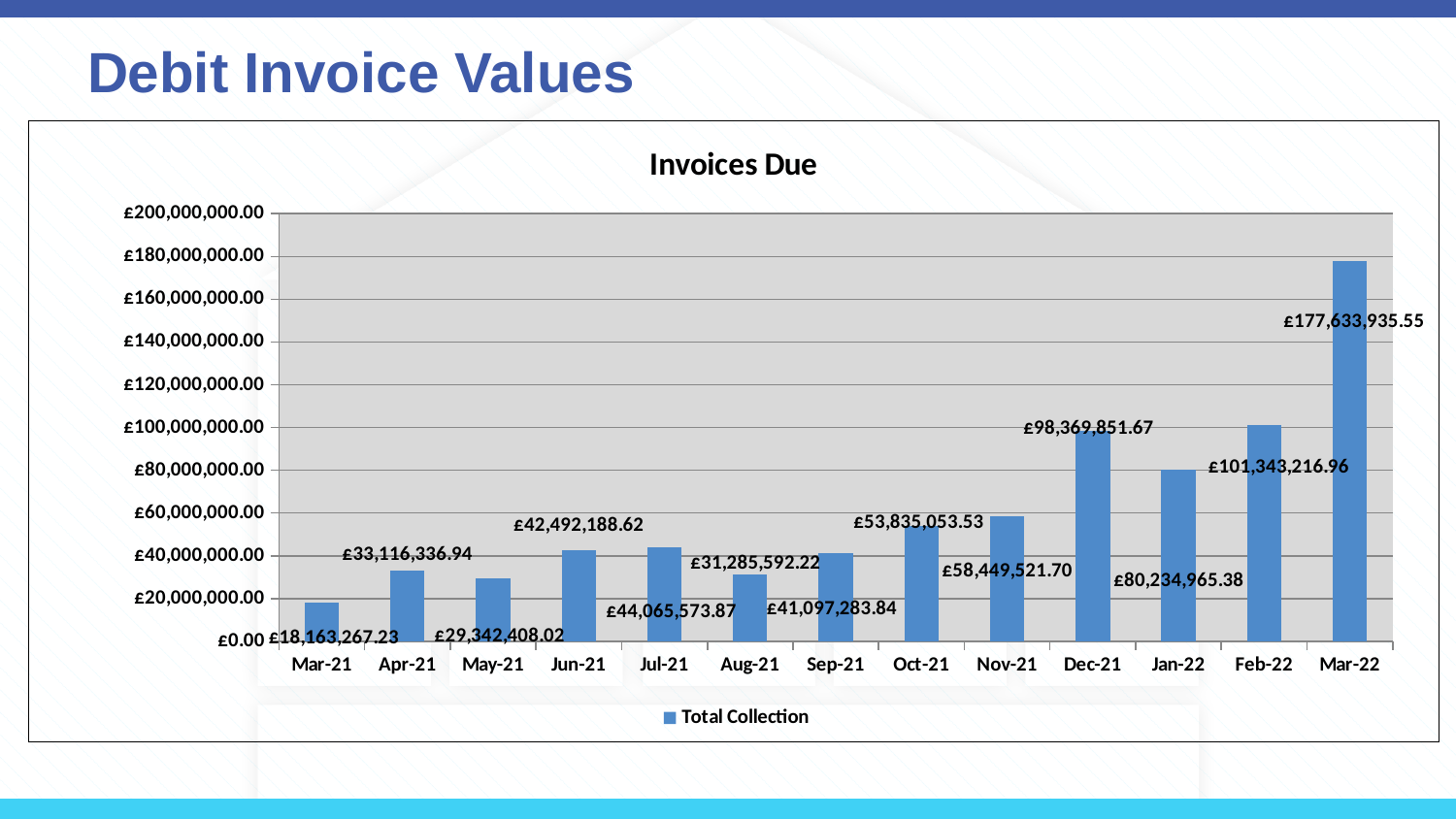
Which month has the lowest value? Mar-21 What is the title of the chart? Invoices Due Which month has the highest value? Mar-22 Is the value for Feb-22 greater or less than £100,000,000.00? greater What is the difference between the values for Mar-22 and Feb-22? £76,290,718.59 What type of chart is shown on the slide? Bar chart How many months are plotted on the x axis? 13 How many series does the legend list? 1 Which is larger, the value for Dec-21 or the value for Jan-22? Dec-21 What is the value for Mar-21? £18,163,267.23 What is the value for Dec-21? £98,369,851.67 What is the value for Mar-22? £177,633,935.55